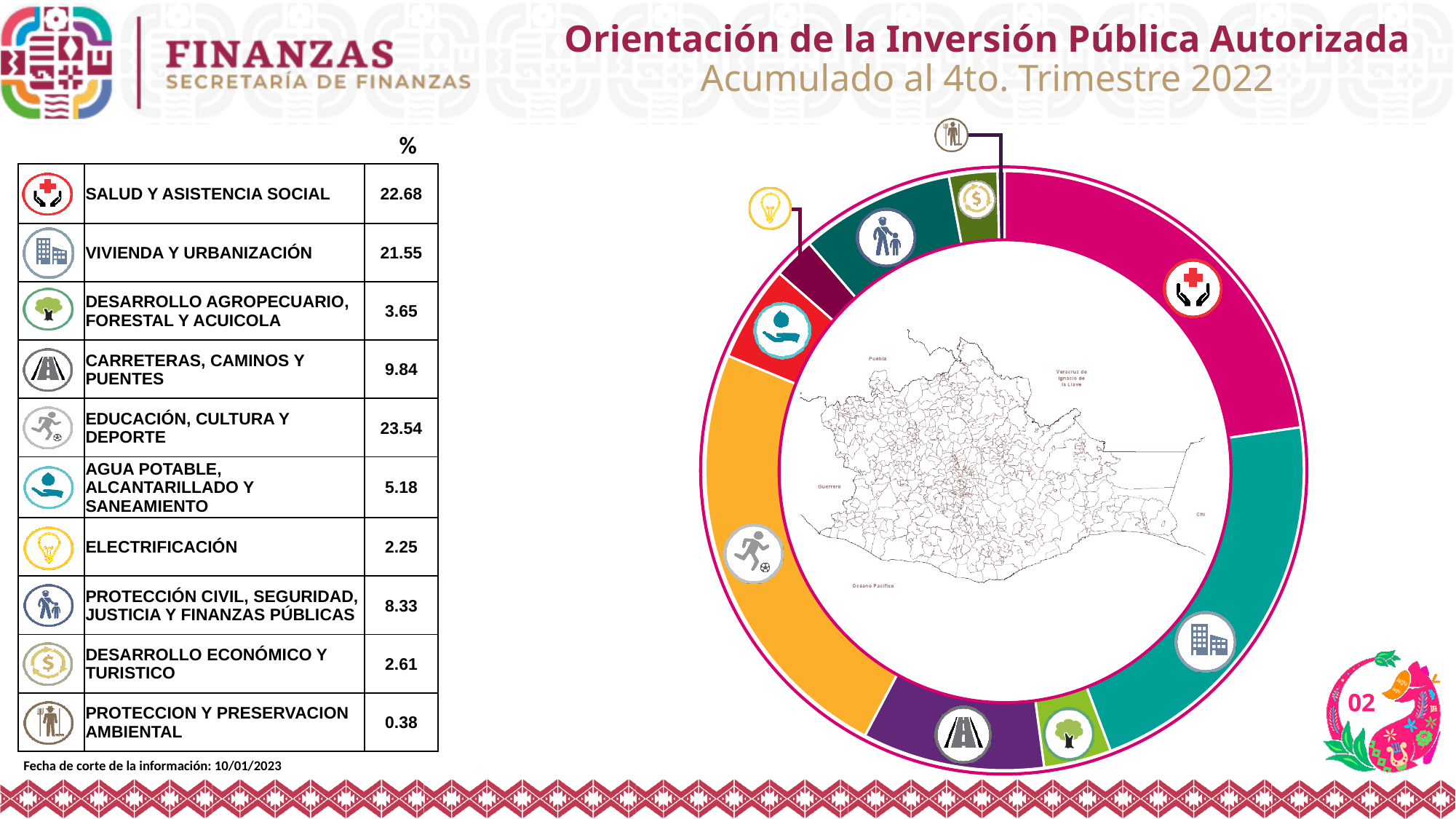
Which category has the highest percentage of authorized public investment? EDUCACIÓN, CULTURA Y DEPORTE What kind of chart is used to show the orientation of authorized public investment? Donut (pie) chart Which has a larger share, SALUD Y ASISTENCIA SOCIAL or VIVIENDA Y URBANIZACIÓN? SALUD Y ASISTENCIA SOCIAL What is the difference in percentage points between EDUCACIÓN, CULTURA Y DEPORTE and SALUD Y ASISTENCIA SOCIAL? 0.86 Which has a larger share, PROTECCIÓN CIVIL, SEGURIDAD, JUSTICIA Y FINANZAS PÚBLICAS or DESARROLLO ECONÓMICO Y TURISTICO? PROTECCIÓN CIVIL, SEGURIDAD, JUSTICIA Y FINANZAS PÚBLICAS What percentage is shown for CARRETERAS, CAMINOS Y PUENTES? 9.84 What percentage is shown for ELECTRIFICACIÓN? 2.25 How many investment categories are shown in the chart? 10 Which category has the lowest percentage of authorized public investment? PROTECCION Y PRESERVACION AMBIENTAL What percentage is shown for AGUA POTABLE, ALCANTARILLADO Y SANEAMIENTO? 5.18 What is the cut-off date of the information shown on the slide? 10/01/2023 What percentage of the authorized public investment goes to SALUD Y ASISTENCIA SOCIAL? 22.68